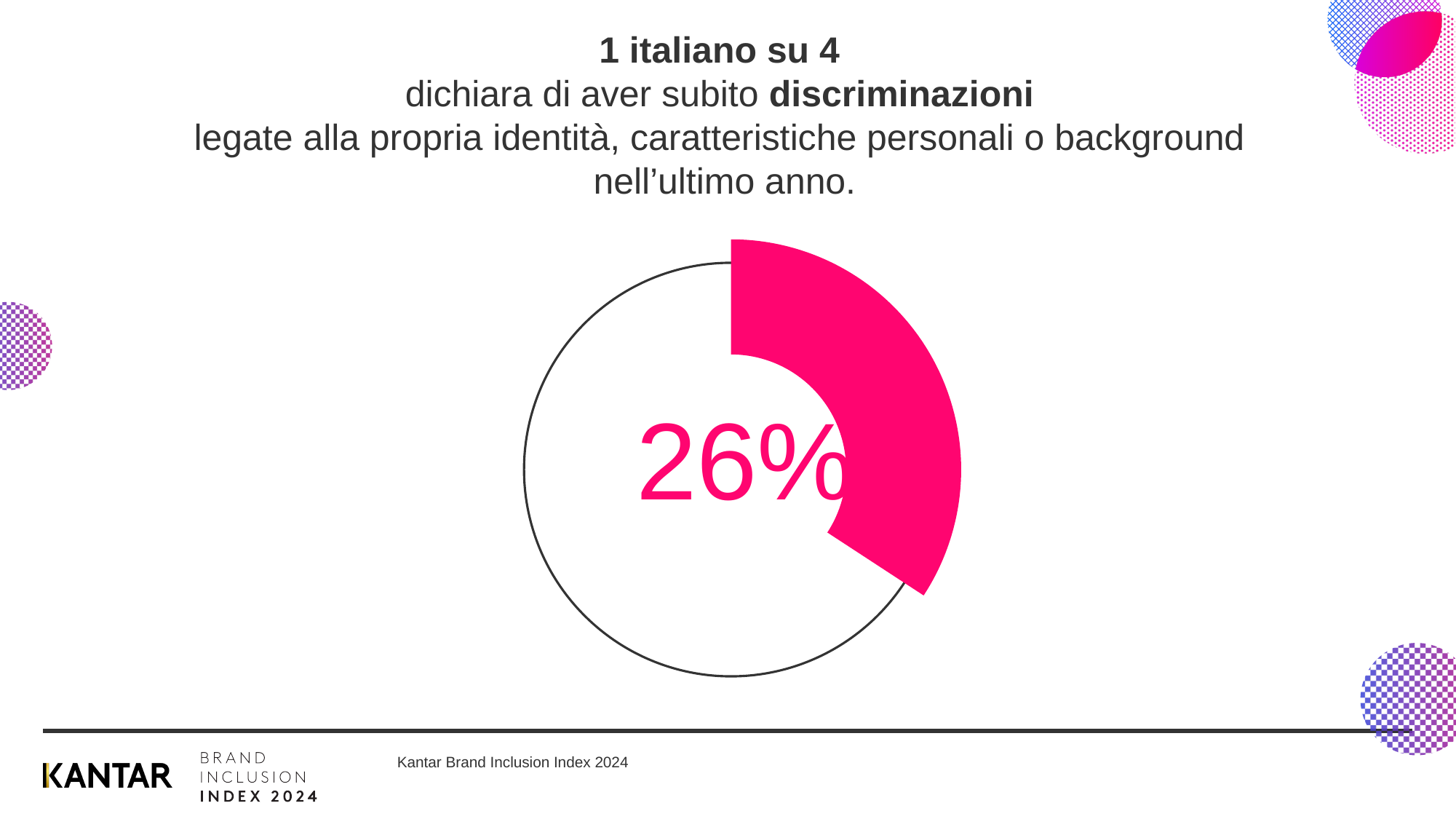
What kind of chart is shown on the slide? pie chart Is the highlighted slice of the pie chart larger or smaller than half of the pie? smaller According to the slide title, how many Italians out of 4 report having experienced discrimination in the last year? 1 What percentage is shown in the centre of the pie chart? 26% What colour is the highlighted slice of the pie chart? pink What share of the pie does the highlighted (filled) slice represent? 26%